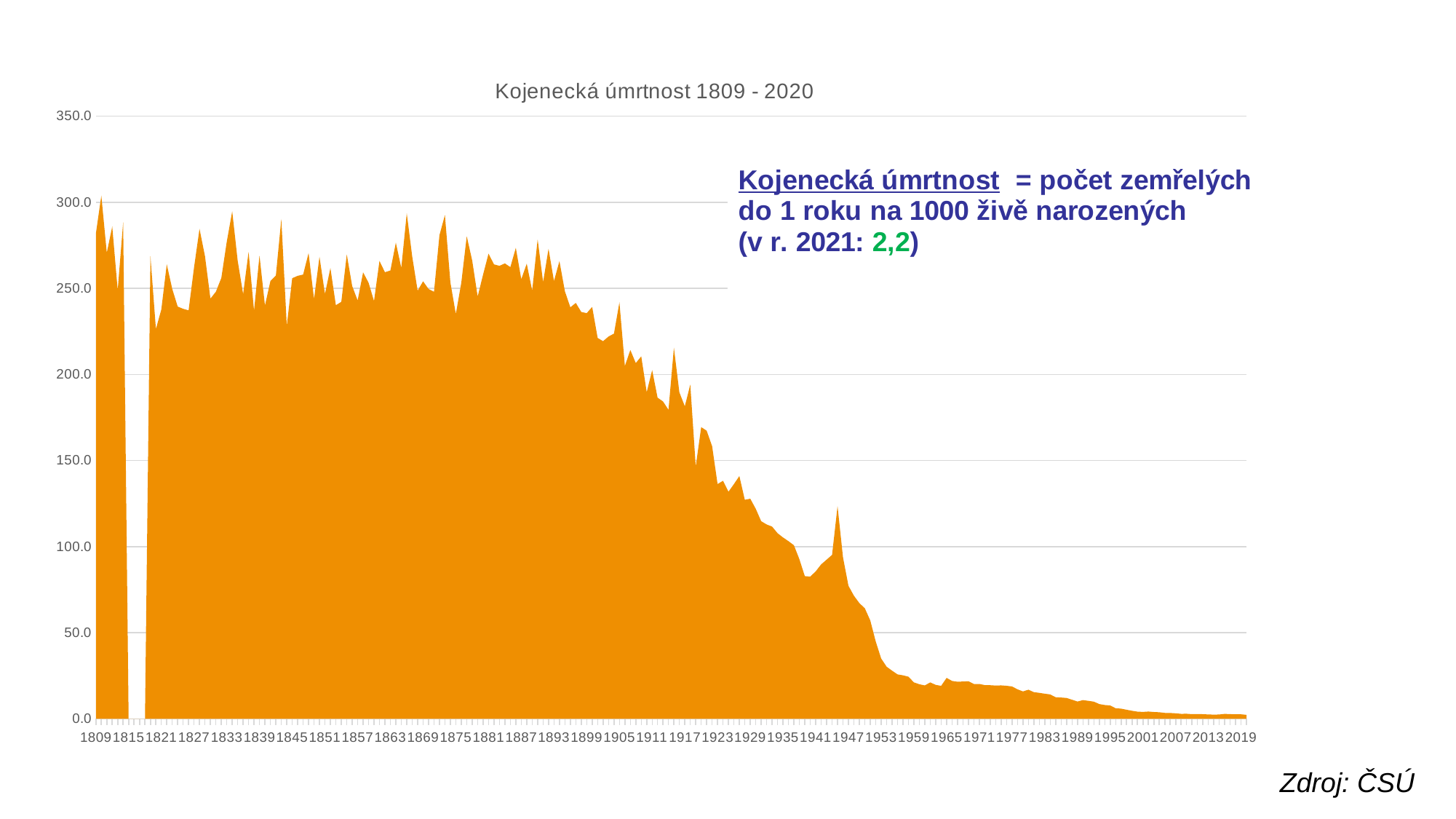
What is the title of the chart? Kojenecká úmrtnost 1809 - 2020 Is the value for 1947 greater or less than 100? less Is the value for 2019 greater or less than 50? less Is the value for 1935 greater or less than 150? less What is the highest value shown on the y axis? 350.0 Overall, do the values rise or fall along the x axis from 1809 to 2019? fall Which is larger, the value for 1845 or the value for 1995? 1845 What kind of chart is shown on the slide? area chart